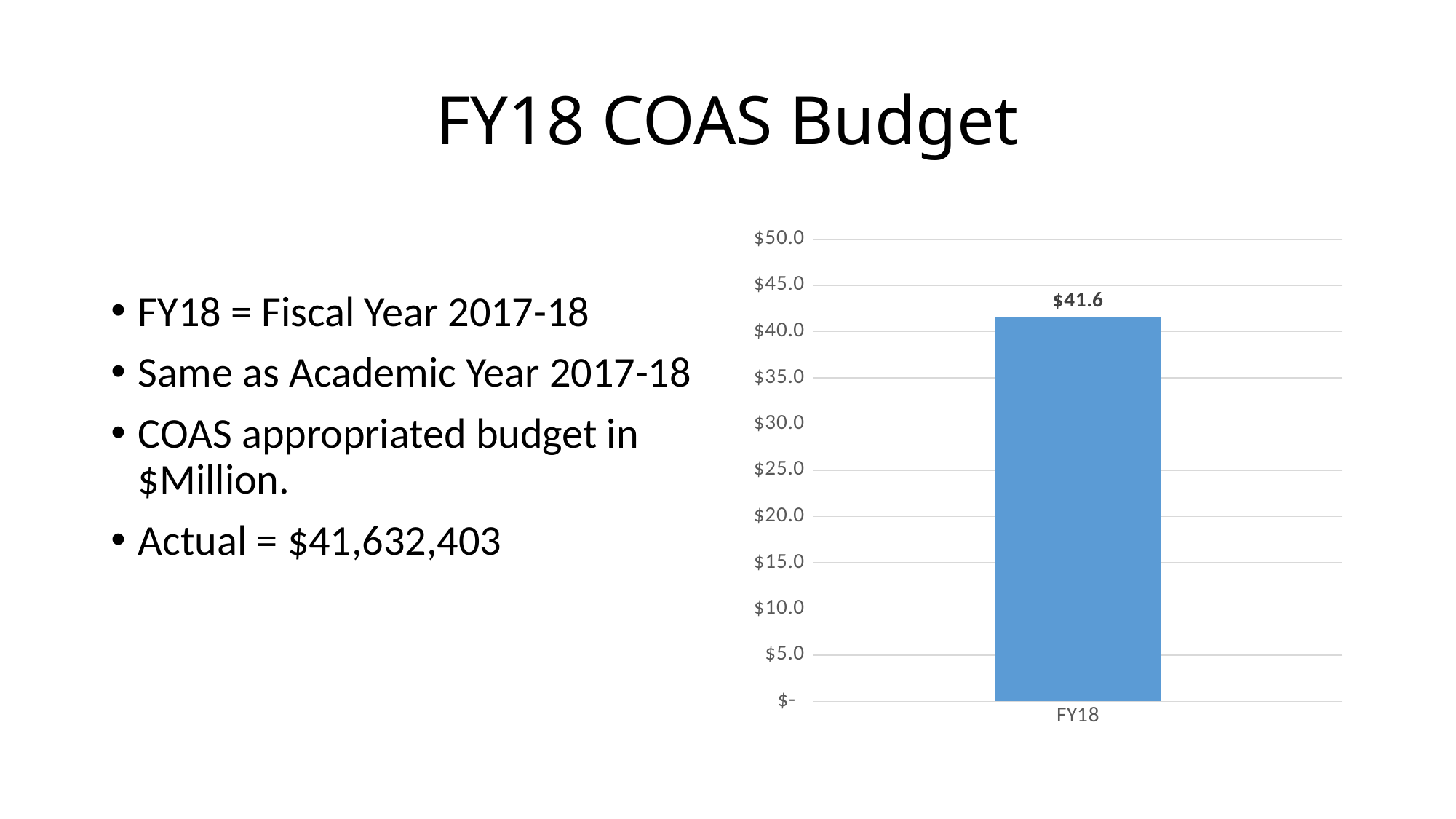
What is the highest tick value shown on the y axis of the chart? $50.0 How many bars are plotted in the chart? 1 Is the value for FY18 greater or less than $45.0? less What colour is the bar in the chart? blue Is the value for FY18 greater or less than $40.0? greater What is the value shown for FY18 in the chart? $41.6 What kind of chart is shown on the slide? bar chart What is the category label on the x axis of the chart? FY18